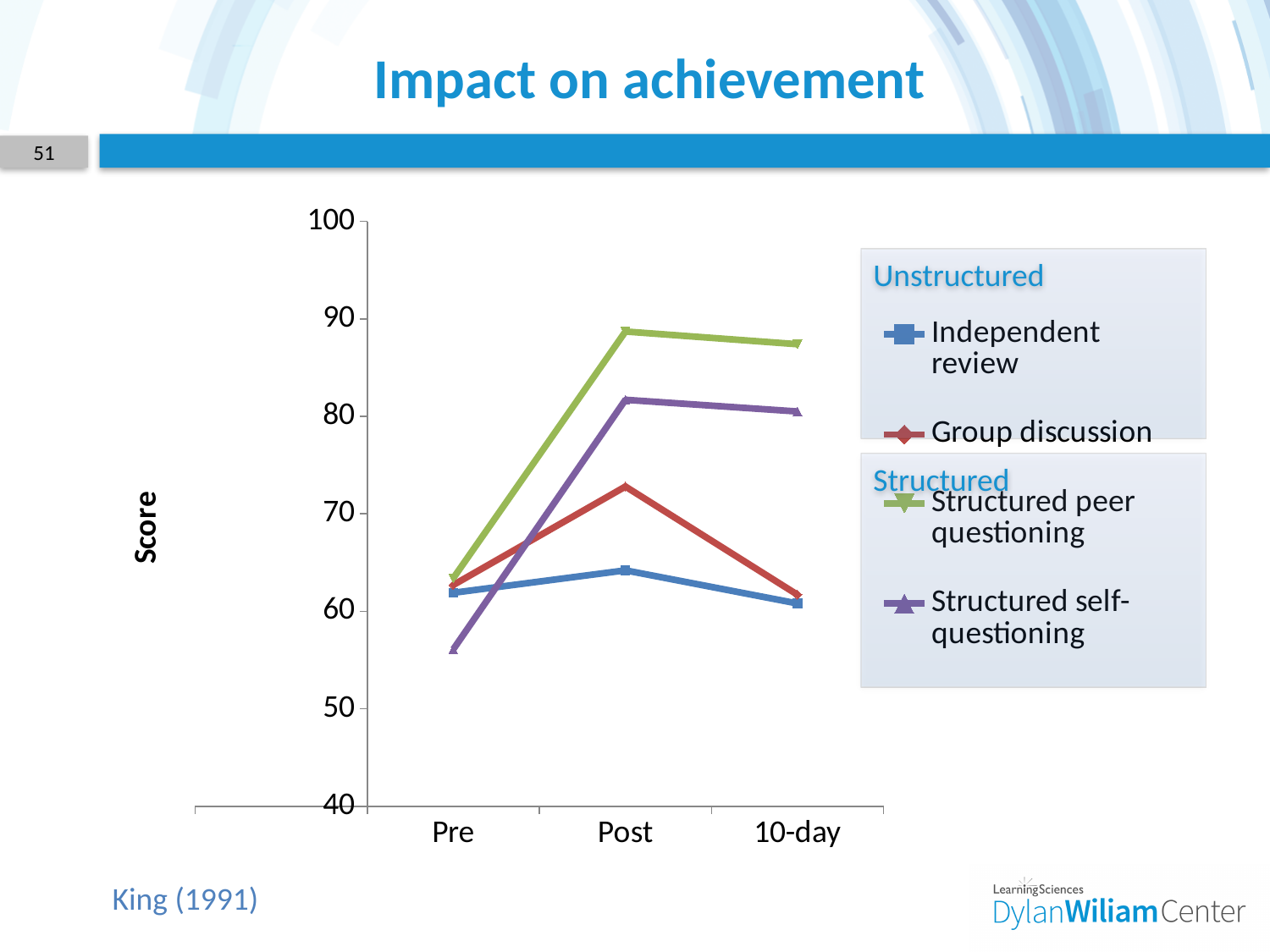
Is the score for Structured self-questioning at Pre greater or less than 60? less Is the score for Structured peer questioning at Post greater or less than 80? greater Which series is drawn in green? Structured peer questioning Does the score for Structured peer questioning rise or fall from Pre to Post? rise How many points are there along the x axis? 3 Which series has the lowest score at Pre? Structured self-questioning Which series has the highest score at Post? Structured peer questioning How many series does the legend list? 4 What kind of chart is shown on the slide? line chart Does the score for Group discussion rise or fall from Post to 10-day? fall At 10-day, which is larger: the score for Structured self-questioning or for Independent review? Structured self-questioning What is the label on the y axis? Score